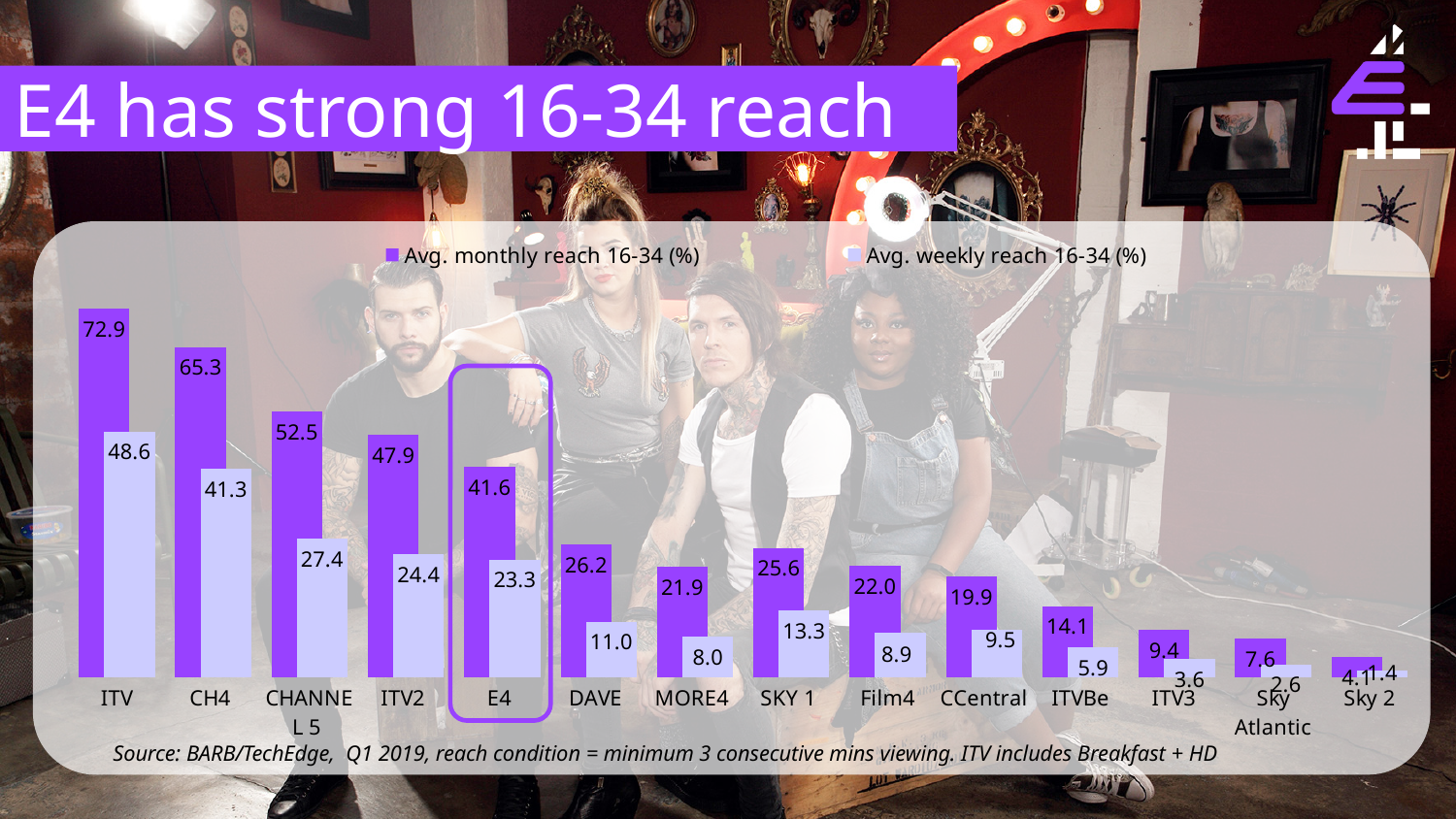
What is the average weekly reach 16-34 (%) for E4? 23.3 What kind of chart is shown on the slide? Bar chart How many channels are shown on the chart? 14 What is the average monthly reach 16-34 (%) for E4? 41.6 What is the difference between ITV's average monthly reach and its average weekly reach 16-34 (%)? 24.3 Do the average monthly reach values generally rise or fall from left to right across the channels? Fall Which channel has the lowest average monthly reach 16-34 (%)? Sky 2 How much higher is CH4's average monthly reach 16-34 (%) than E4's? 23.7 Which has the higher average monthly reach 16-34 (%), DAVE or SKY 1? DAVE Which channel has the highest average monthly reach 16-34 (%)? ITV What is the title of the slide? E4 has strong 16-34 reach How many series does the legend list? 2